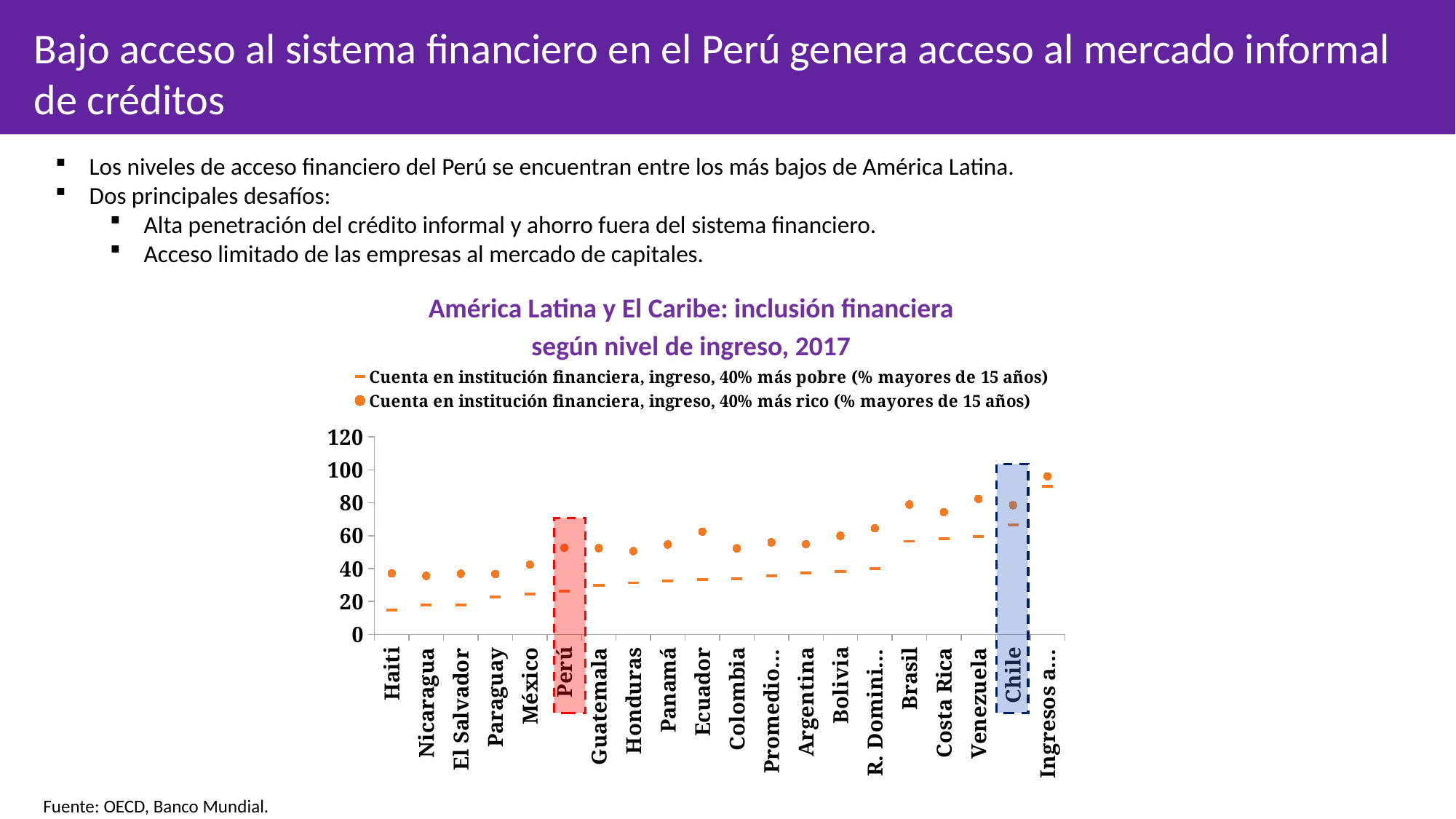
Which category has the lowest value in the series 'Cuenta en institución financiera, ingreso, 40% más pobre'? Haiti How many categories are plotted along the x axis of the chart? 20 Do the values in the series 'Cuenta en institución financiera, ingreso, 40% más rico' generally rise or fall from left to right along the x axis? rise Is the value for Haiti in the series 'Cuenta en institución financiera, ingreso, 40% más pobre' greater or less than 20? less What is the title of the chart? América Latina y El Caribe: inclusión financiera según nivel de ingreso, 2017 Is the value for Chile in the series 'Cuenta en institución financiera, ingreso, 40% más rico' greater or less than 60? greater Is the value for Perú in the series 'Cuenta en institución financiera, ingreso, 40% más rico' greater or less than 40? greater How many series does the chart legend list? 2 What kind of chart is shown on the slide? scatter (dot) chart Which is larger in the series 'Cuenta en institución financiera, ingreso, 40% más rico': the value for Chile or the value for Perú? Chile